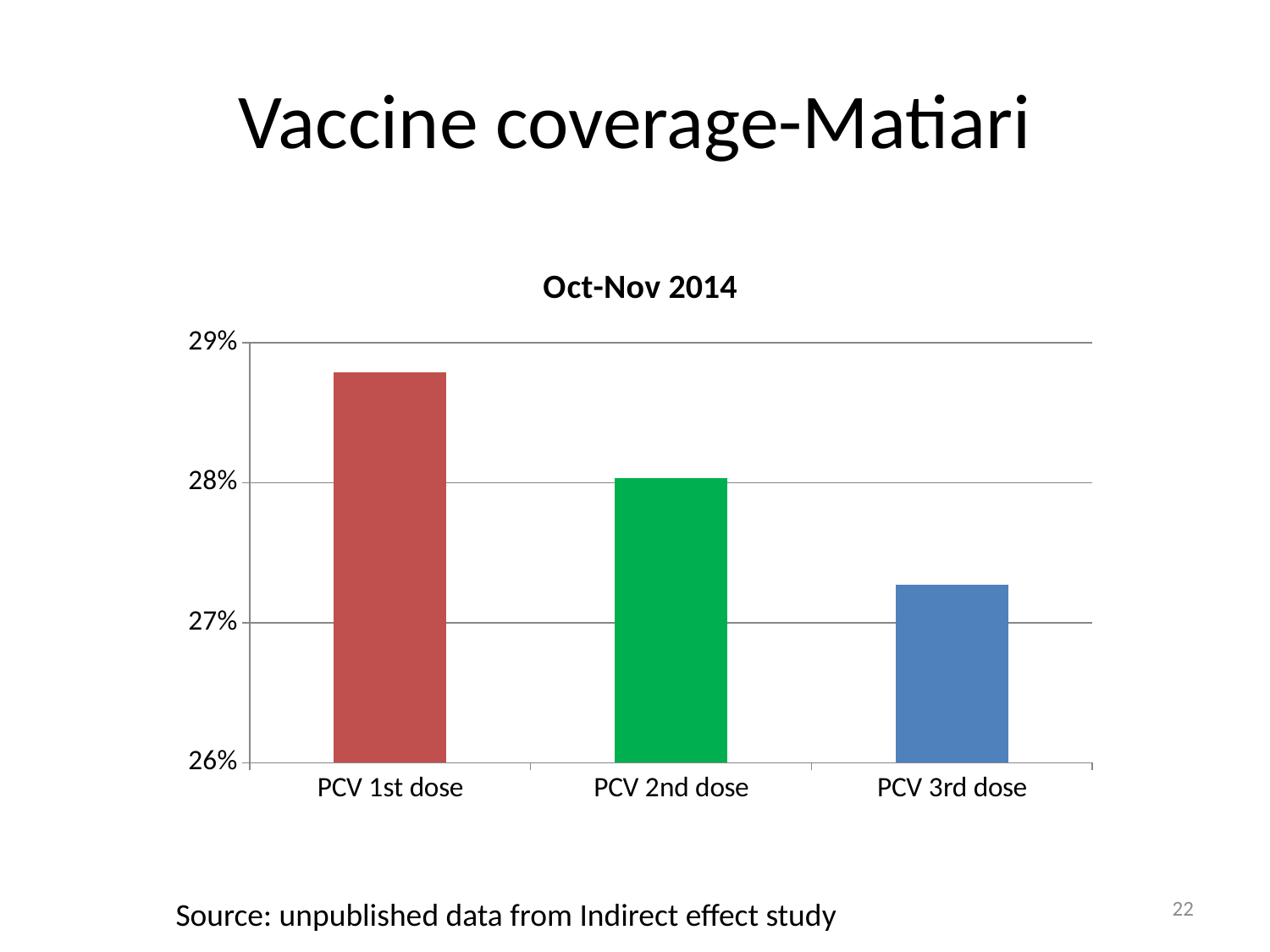
Which category has the lowest value? PCV 3rd dose What is the title of the chart? Oct-Nov 2014 What kind of chart is shown on the slide? bar chart Is the value for PCV 3rd dose greater or less than 28%? less Is the value for PCV 1st dose greater or less than 28%? greater What colour is the bar for PCV 2nd dose? green Which is larger, the value for PCV 1st dose or PCV 3rd dose? PCV 1st dose Do the values rise or fall from PCV 1st dose to PCV 3rd dose? fall How many categories are plotted in the chart? 3 Which category has the highest value? PCV 1st dose Which is larger, the value for PCV 2nd dose or PCV 3rd dose? PCV 2nd dose Is the value for PCV 3rd dose greater or less than 27%? greater